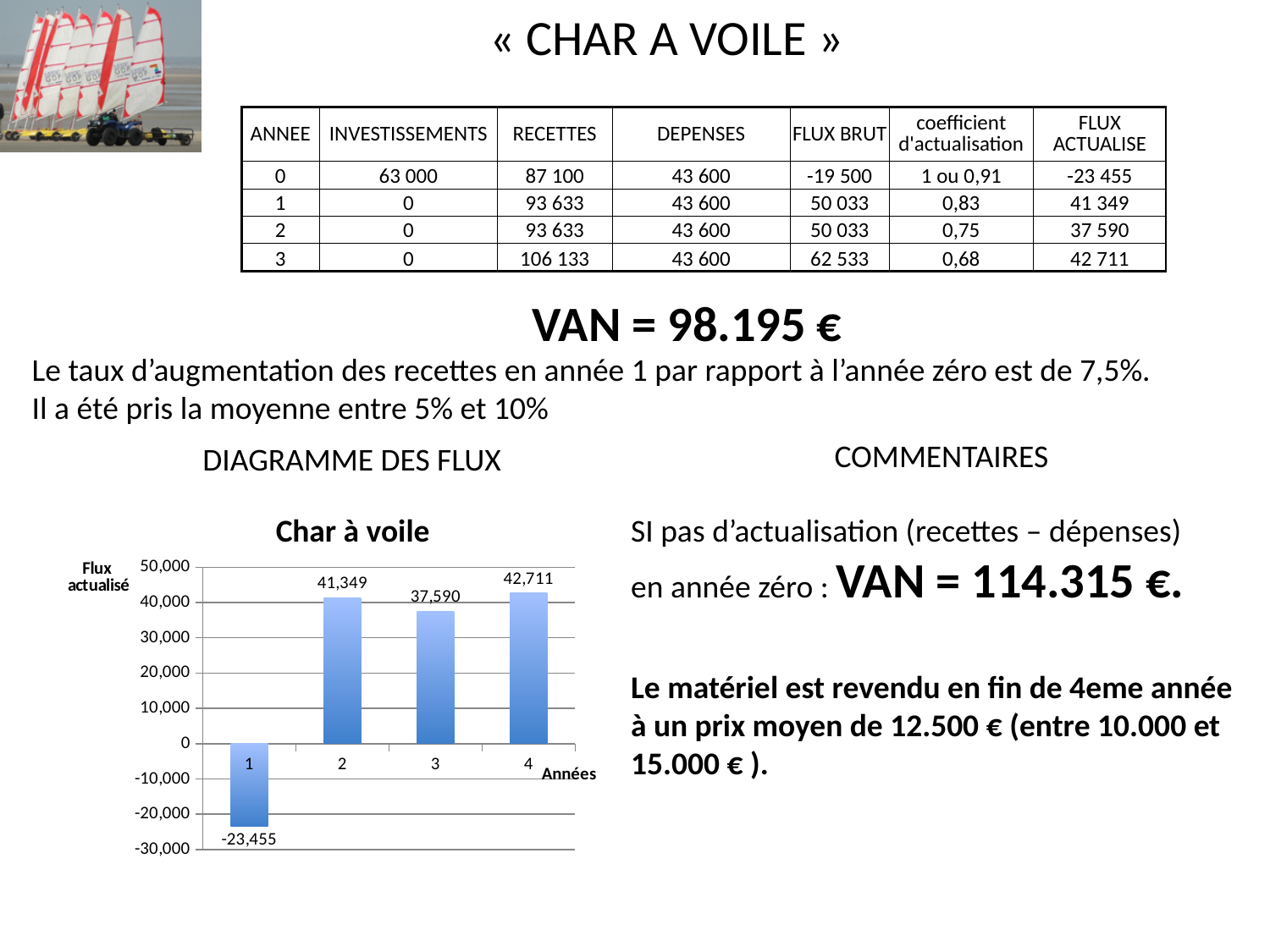
What is the title of the chart on the slide? Char à voile What is the value shown for year 1 in the 'Char à voile' chart? -23,455 What type of chart is shown under 'DIAGRAMME DES FLUX'? bar chart Which year has the highest value in the 'Char à voile' chart? 4 What is the value shown for year 4 in the 'Char à voile' chart? 42,711 In the 'Char à voile' chart, which is larger: the value for year 2 or the value for year 3? year 2 What is the value shown for year 2 in the 'Char à voile' chart? 41,349 Which year has the lowest value in the 'Char à voile' chart? 1 In the 'Char à voile' chart, what is the difference between the values for year 4 and year 3? 5,121 What label is shown on the horizontal axis of the 'Char à voile' chart? Années How many bars (years) are plotted in the 'Char à voile' chart? 4 What is the value shown for year 3 in the 'Char à voile' chart? 37,590